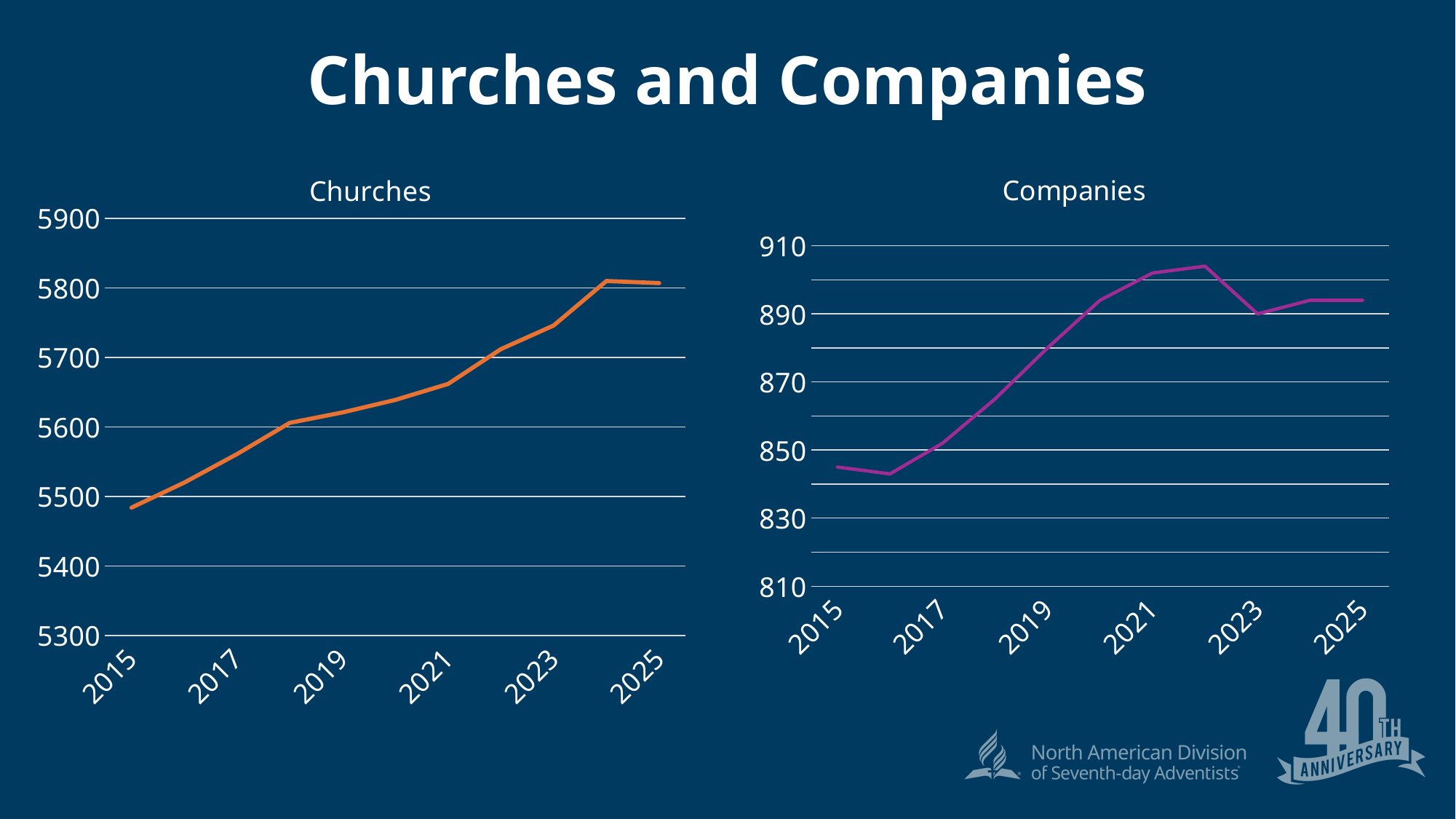
What kind of chart is the Churches chart? line chart What kind of chart is the Companies chart? line chart In the Companies chart, is the value for 2015 greater or less than 850? less In the Companies chart, do the values generally rise or fall from 2015 to 2025? rise What is the title of the slide? Churches and Companies In the Companies chart, which is larger, the value for 2019 or the value for 2023? 2023 In the Churches chart, is the value for 2021 greater or less than 5700? less In the Companies chart, is the value for 2023 greater or less than 900? less In the Churches chart, which year has the lowest value? 2015 In the Churches chart, do the values generally rise or fall from 2015 to 2025? rise